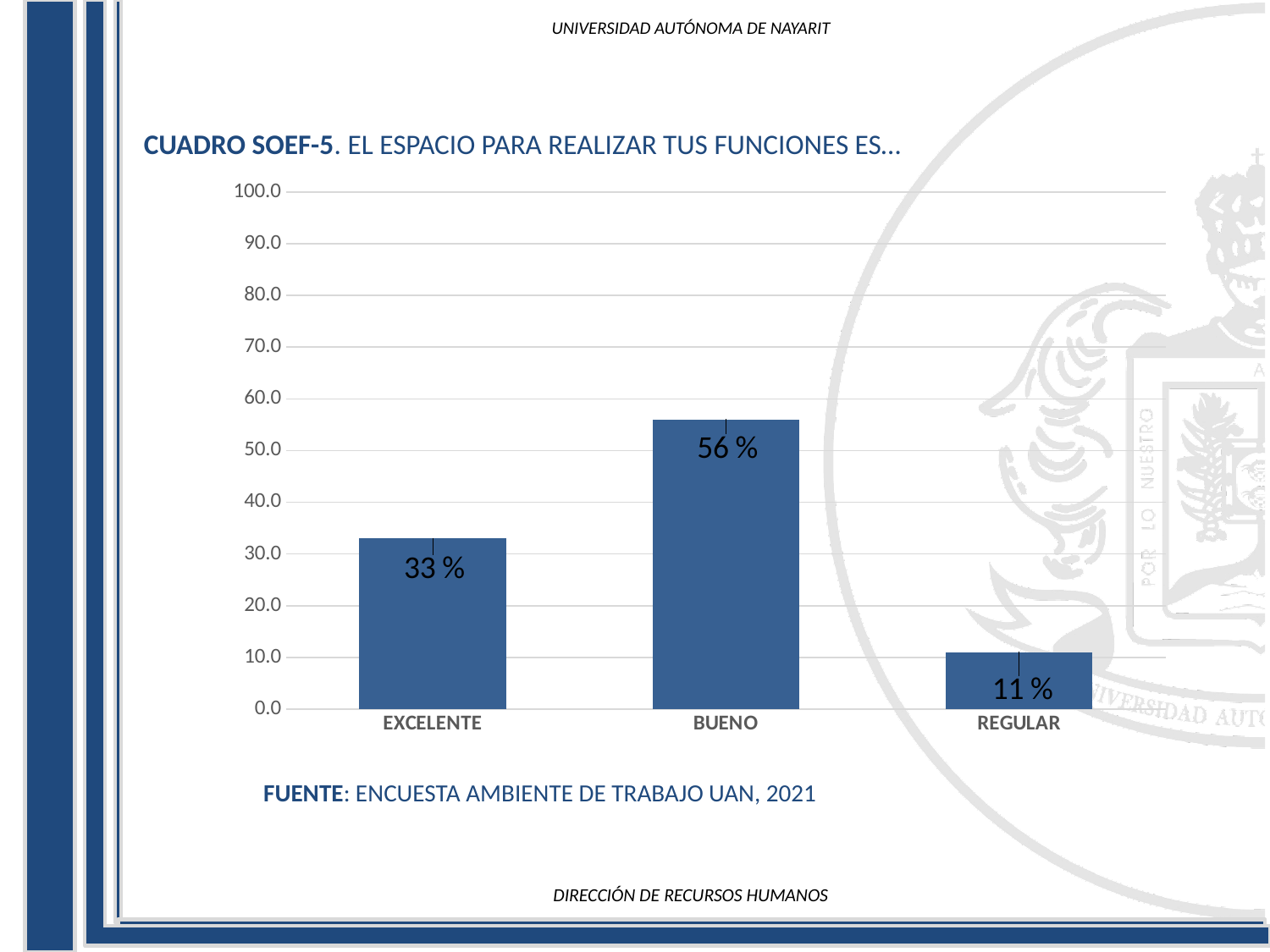
What is the difference between the values for BUENO and EXCELENTE? 23 % Which category has the highest value? BUENO Is the value for BUENO greater or less than 50.0? greater How many categories are shown on the x axis? 3 What is the value for EXCELENTE? 33 % What is the value for BUENO? 56 % What is the difference between the values for EXCELENTE and REGULAR? 22 % What is the source cited below the chart? ENCUESTA AMBIENTE DE TRABAJO UAN, 2021 Which is larger, the value for EXCELENTE or the value for REGULAR? EXCELENTE What is the value for REGULAR? 11 % What kind of chart is shown on the slide? bar chart Which category has the lowest value? REGULAR